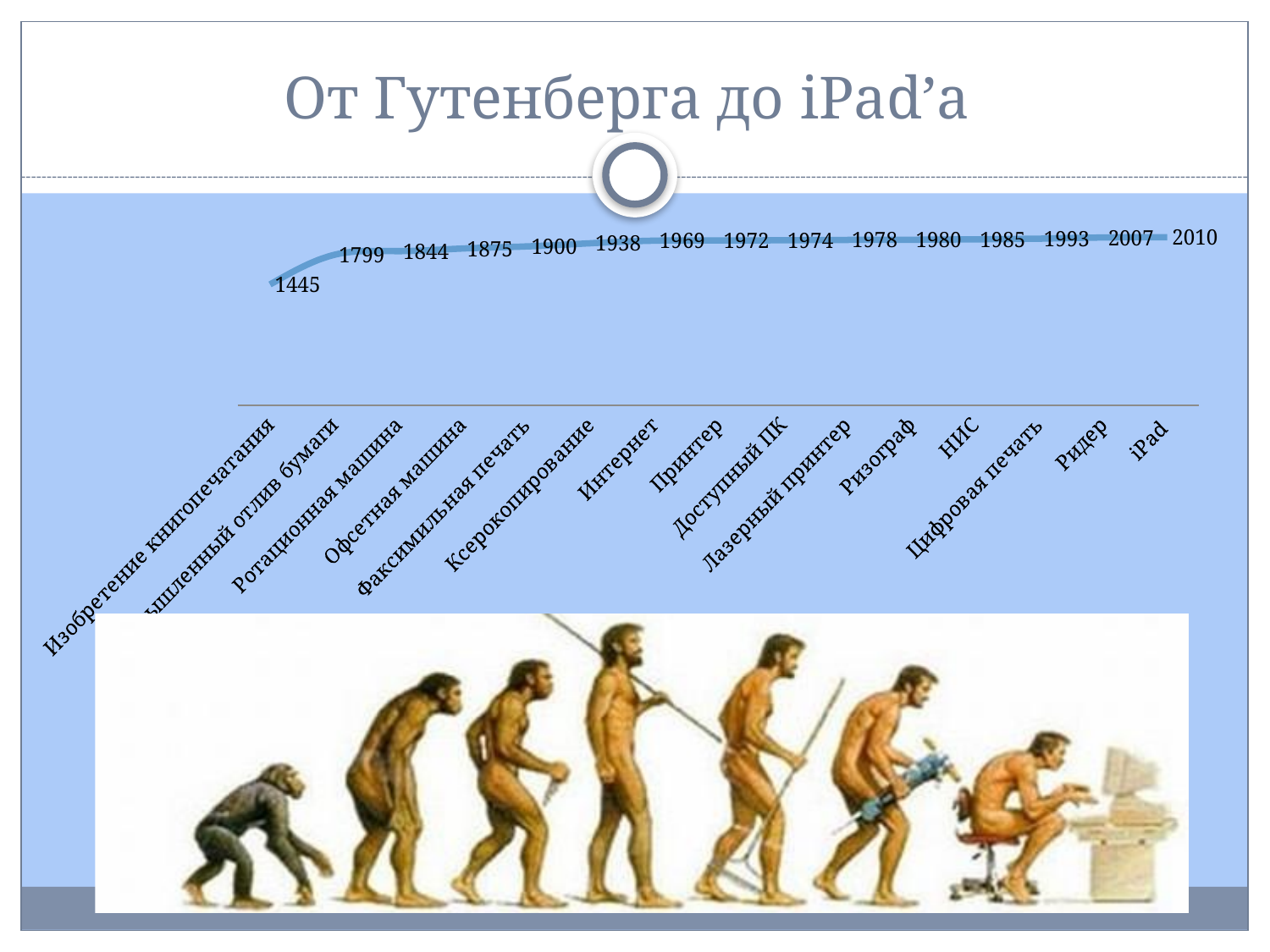
What year is shown for iPad? 2010 Which category has the highest value on the chart? iPad What is the title of the chart slide? От Гутенберга до iPad’a What is the difference between the values for Ротационная машина and Офсетная машина? 31 Do the values rise or fall along the x axis from left to right? rise What year is shown for Ксерокопирование? 1938 What year is shown for Ридер? 2007 What year is shown for Интернет? 1969 What year is shown for Изобретение книгопечатания? 1445 Which category has the lowest value on the chart? Изобретение книгопечатания What type of chart is shown on the slide? line chart How many categories are plotted on the chart? 15